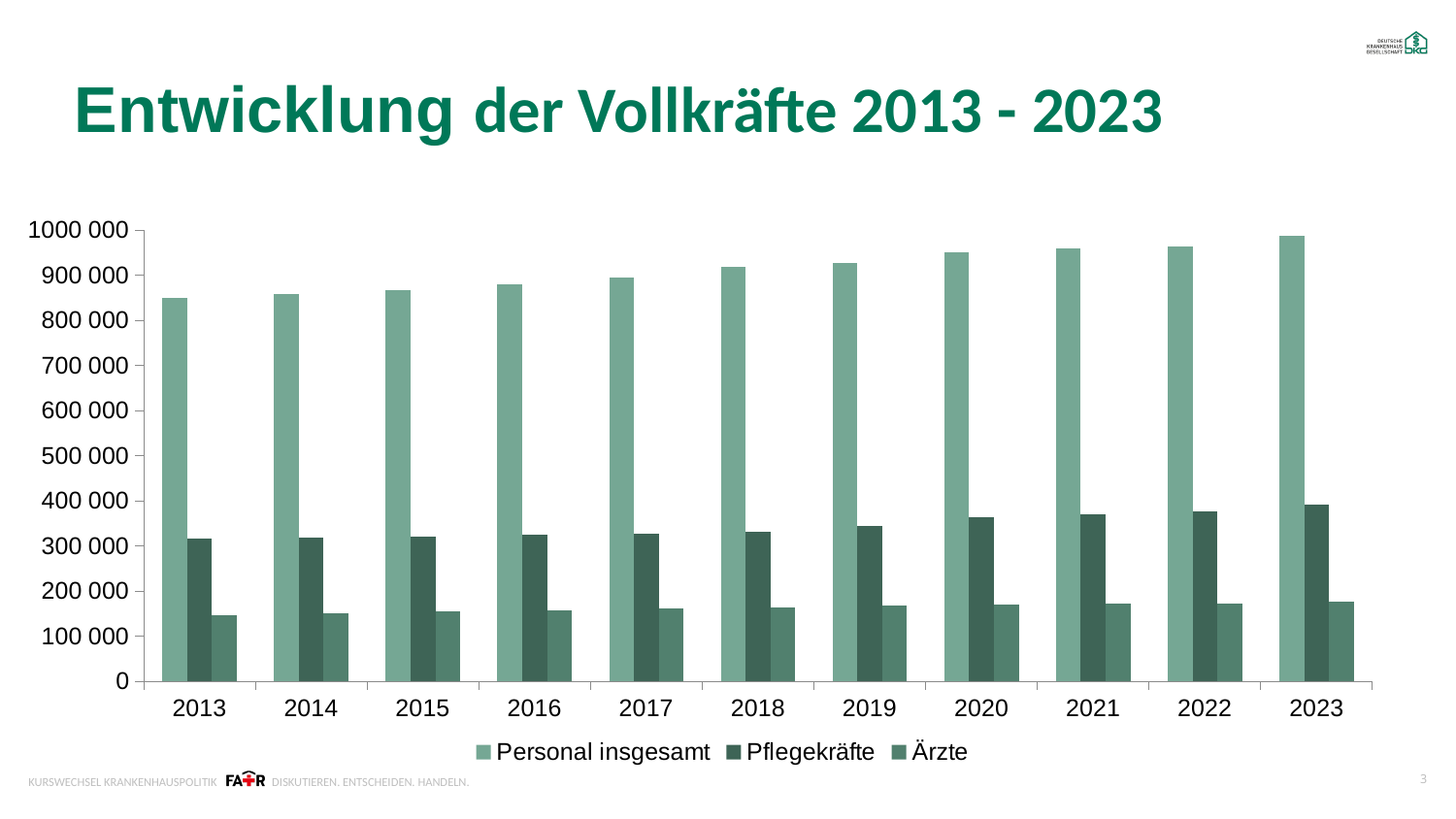
Do the values for Pflegekräfte rise or fall from 2013 to 2023? rise Is the value for Pflegekräfte in 2023 greater or less than 300 000? greater In which year is the value for Personal insgesamt highest? 2023 How many years are shown on the x axis? 11 How many series does the legend list? 3 Which is larger in 2023, the value for Pflegekräfte or the value for Ärzte? Pflegekräfte What is the title of the chart on the slide? Entwicklung der Vollkräfte 2013 - 2023 Is the value for Ärzte in 2013 greater or less than 200 000? less What kind of chart is shown on the slide? bar chart In which year is the value for Personal insgesamt lowest? 2013 Is the value for Personal insgesamt in 2023 greater or less than 900 000? greater